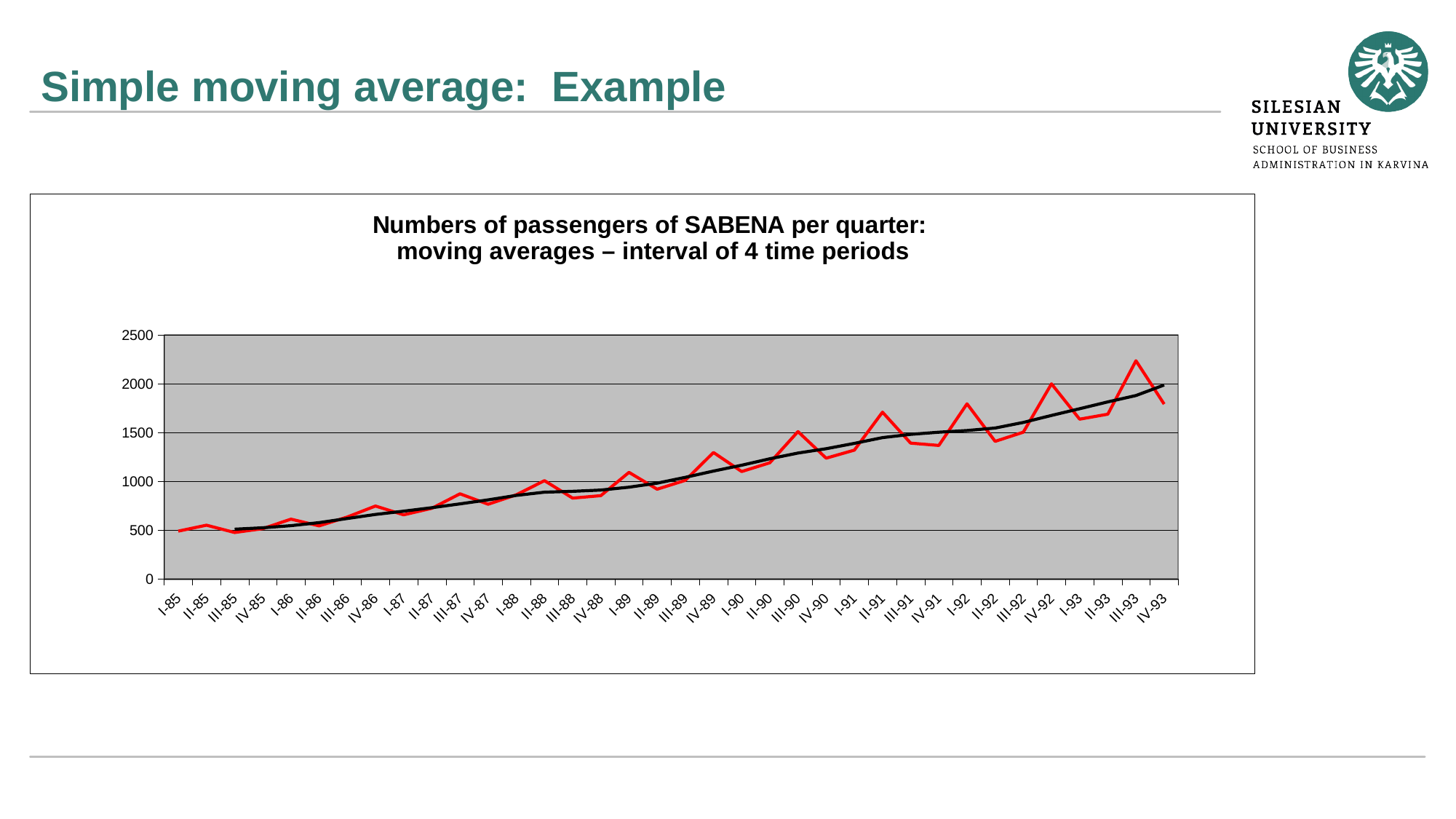
How many lines are plotted on the chart? 2 What is the title of the chart? Numbers of passengers of SABENA per quarter: moving averages – interval of 4 time periods What kind of chart is shown on the slide? line chart Is the value of the red line for IV-89 greater or less than 1500? less Which quarter has the higher value on the red line, II-88 or II-91? II-91 Is the value of the red line for I-85 greater or less than 1000? less Is the value of the red line for II-91 greater or less than 1500? greater How many quarters are shown along the x axis of the chart? 36 In which quarter does the red line reach its highest value? III-93 Do the values on the chart generally rise or fall from I-85 to IV-93? rise